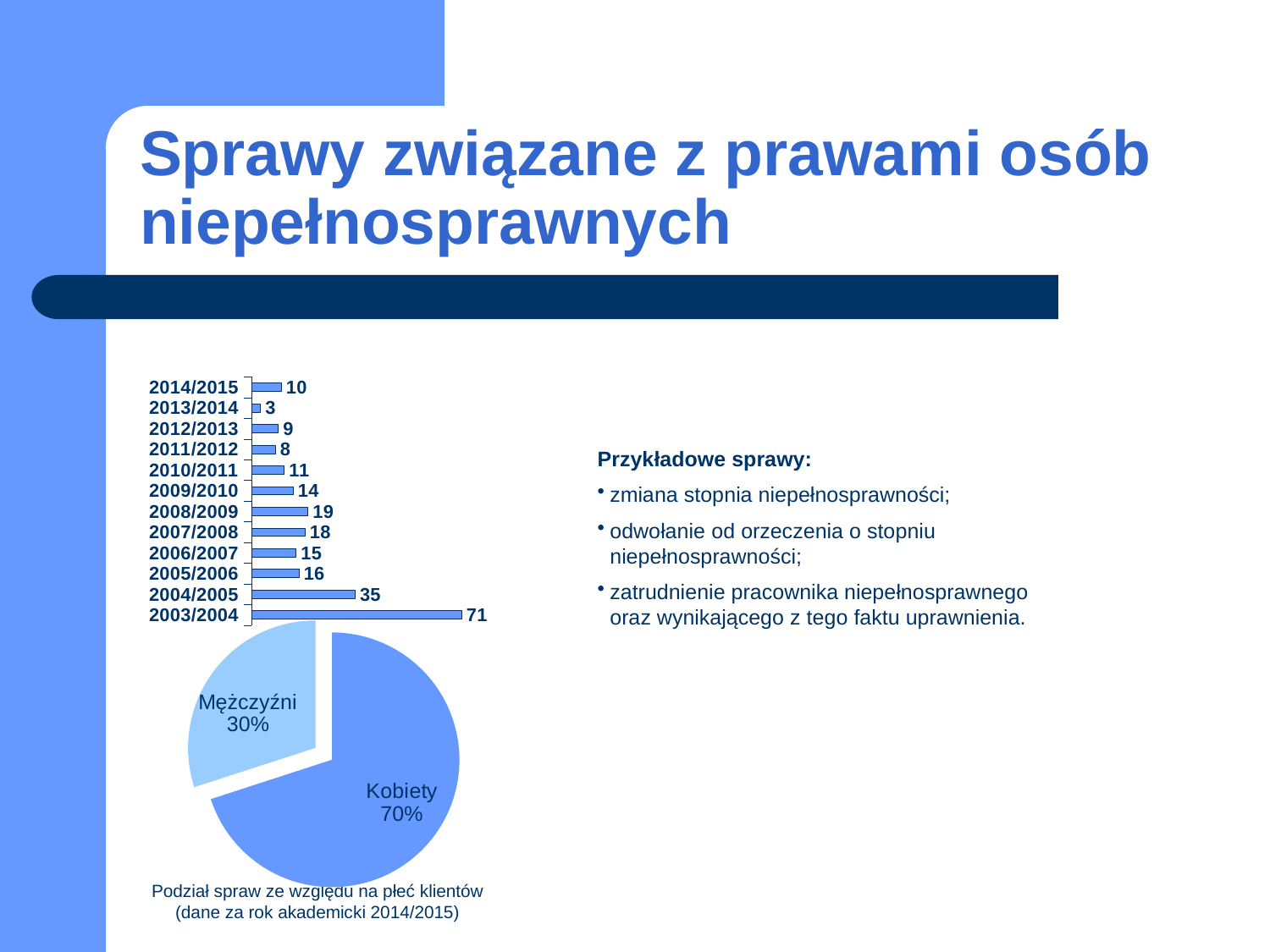
In the bar chart, what is the value for 2014/2015? 10 In the bar chart, what is the value for 2003/2004? 71 What kind of chart is the upper chart on the slide? bar chart In the bar chart, which academic year has the highest value? 2003/2004 How many academic years are shown in the bar chart? 12 In the bar chart, which academic year has the lowest value? 2013/2014 How many slices does the pie chart have? 2 What is the caption below the pie chart? Podział spraw ze względu na płeć klientów (dane za rok akademicki 2014/2015) In the pie chart, what share is labelled Mężczyźni? 30% In the bar chart, what is the difference between the values for 2003/2004 and 2004/2005? 36 In the bar chart, which is larger: the value for 2008/2009 or the value for 2009/2010? 2008/2009 In the pie chart, what share is labelled Kobiety? 70%